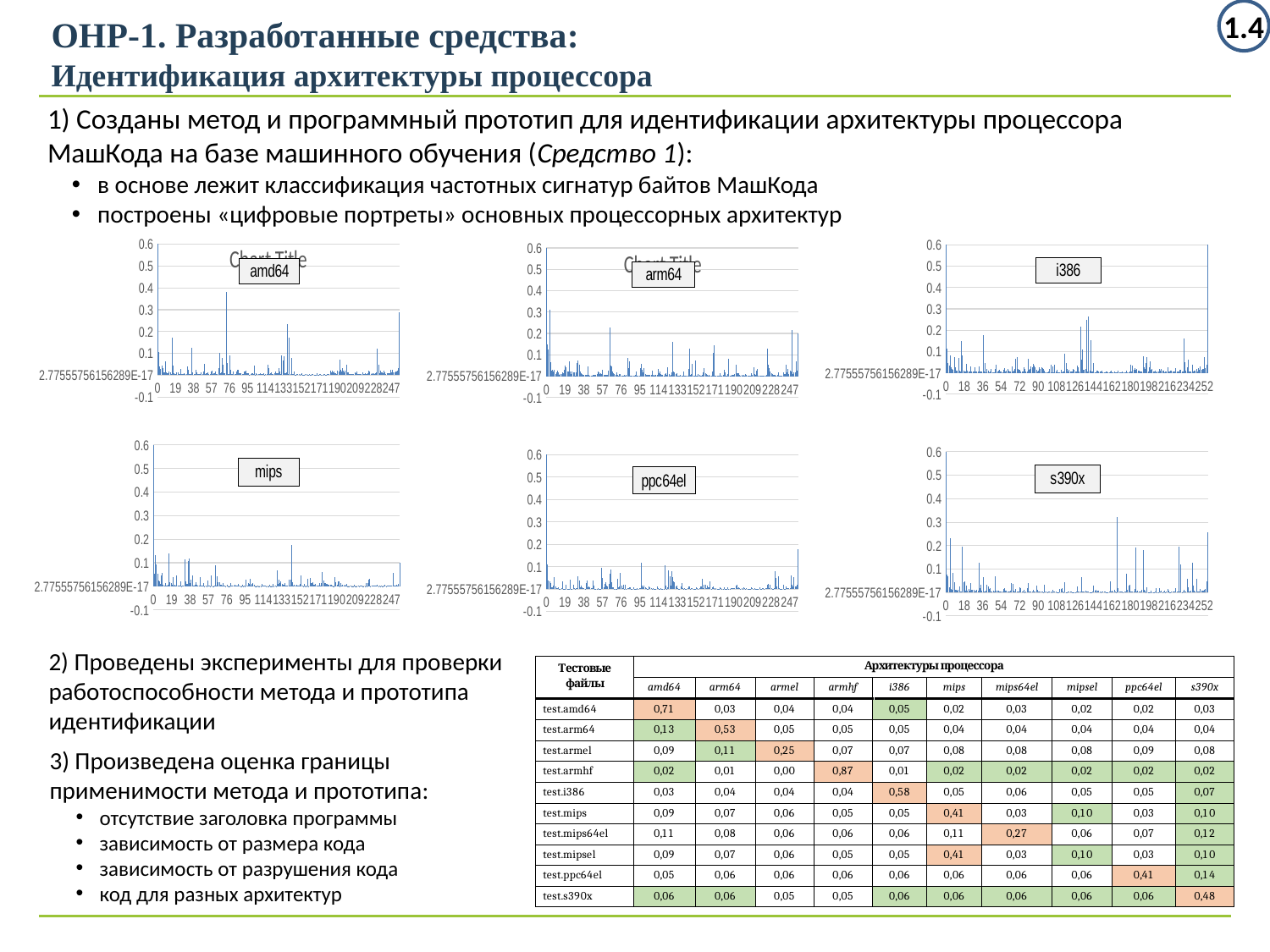
Which processor architecture is labelled on the chart in the top-right position? i386 In the mips chart, is the tallest bar greater or less than 0.3? less What kind of chart is the amd64 chart? bar chart In the amd64 chart, is the tallest bar greater or less than 0.4? greater What is the last tick label on the x axis of the s390x chart? 252 In the i386 chart, is the tallest bar greater or less than 0.5? greater What is the last tick label on the x axis of the amd64 chart? 247 How many charts are shown on the slide? 6 What is the highest tick value shown on the y axis of the mips chart? 0.6